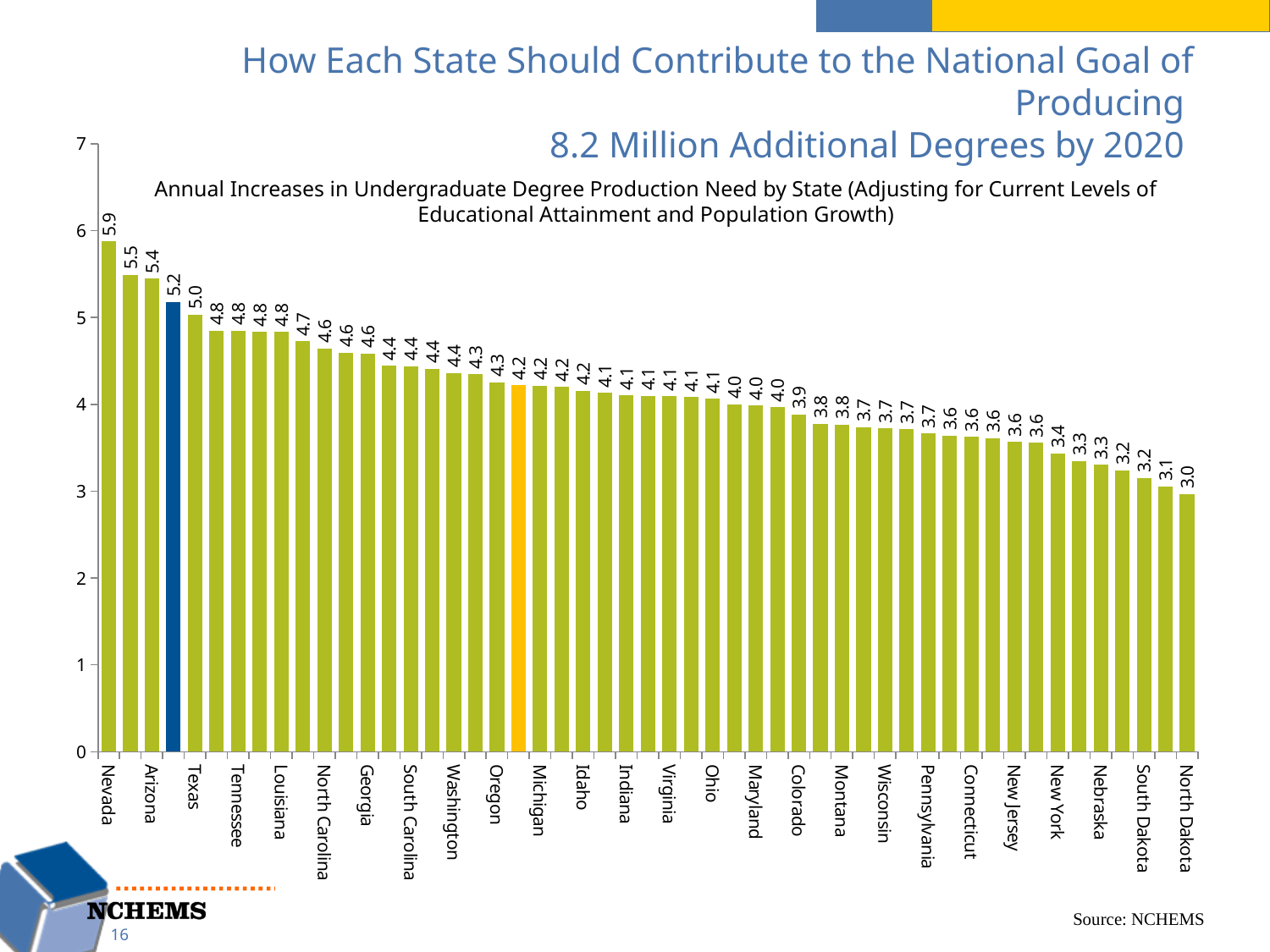
What is the value shown for North Dakota? 3.0 What kind of chart is shown on the slide? bar chart Do the values rise or fall moving from left to right along the x axis? fall What is the source cited for the chart? NCHEMS Which state has the highest value in the chart? Nevada Which state has the lowest value in the chart? North Dakota Is the value for Nevada greater or less than 5? greater Is the value for North Dakota greater or less than 4? less What is the value shown for Arizona? 5.4 Which has a larger value, Nevada or Arizona? Nevada What is the difference between the values for Nevada and North Dakota? 2.9 What is the value shown for Nevada? 5.9